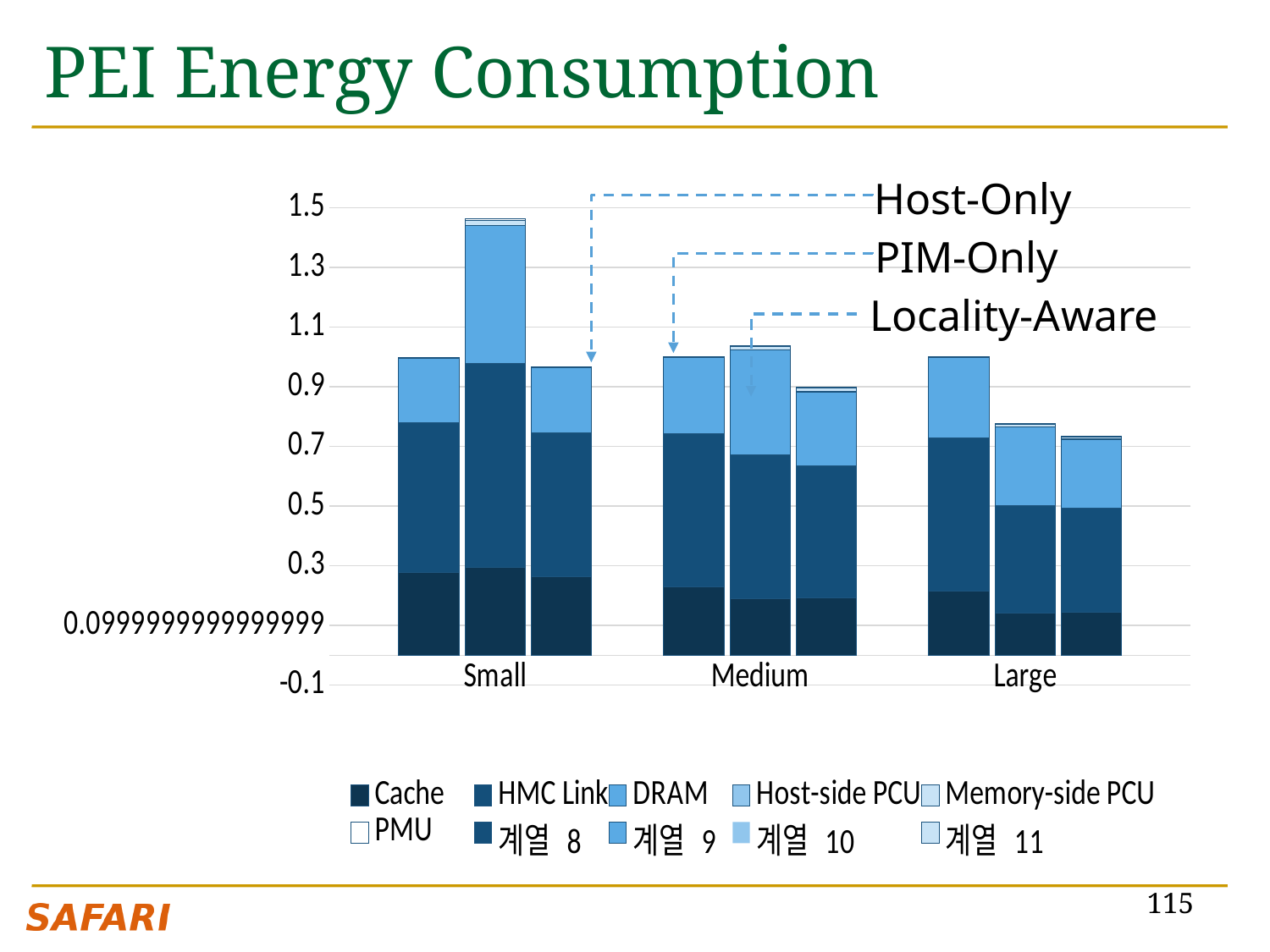
Which category has the shortest Locality-Aware bar? Large How many categories (groups) are shown on the x axis? 3 How many series does the legend list? 10 What is the title of the chart? PEI Energy Consumption Is the total of the PIM-Only bar for Large greater or less than 0.9? less Which category has the tallest PIM-Only bar? Small What kind of chart is shown on the slide? stacked bar chart Do the Locality-Aware bar totals rise or fall from Small to Large? fall Which three configurations are labeled by the dashed arrows above the bars? Host-Only, PIM-Only, Locality-Aware Is the total of the Locality-Aware bar for Small greater or less than 1.1? less For Medium, which bar is taller: PIM-Only or Locality-Aware? PIM-Only Is the total of the PIM-Only bar for Small greater or less than 1.3? greater